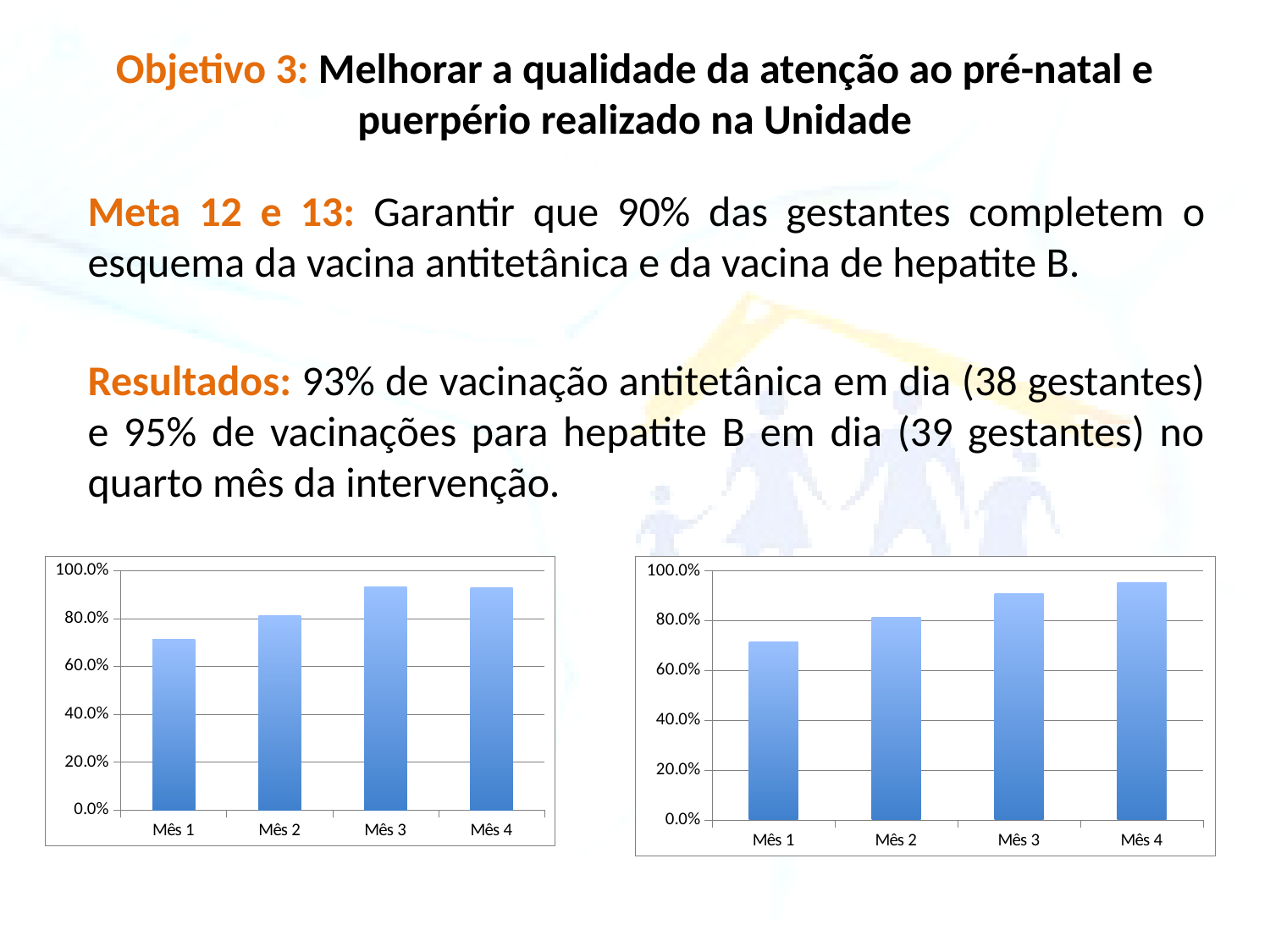
In the chart on the left of the slide, is the value for Mês 3 greater or less than 80%? greater In the chart on the left of the slide, is the value for Mês 1 greater or less than 80%? less What kind of chart is the chart on the left of the slide? bar chart In the chart on the right of the slide, is the value for Mês 4 greater or less than 80%? greater In the chart on the right of the slide, do the values rise or fall from Mês 1 to Mês 4? rise In the chart on the left of the slide, which is larger, the value for Mês 1 or the value for Mês 2? Mês 2 How many categories are shown on the x axis of the chart on the right of the slide? 4 In the chart on the right of the slide, which is larger, the value for Mês 2 or the value for Mês 4? Mês 4 In the chart on the right of the slide, which month has the highest value? Mês 4 In the chart on the right of the slide, which month has the lowest value? Mês 1 In the chart on the left of the slide, which month has the lowest value? Mês 1